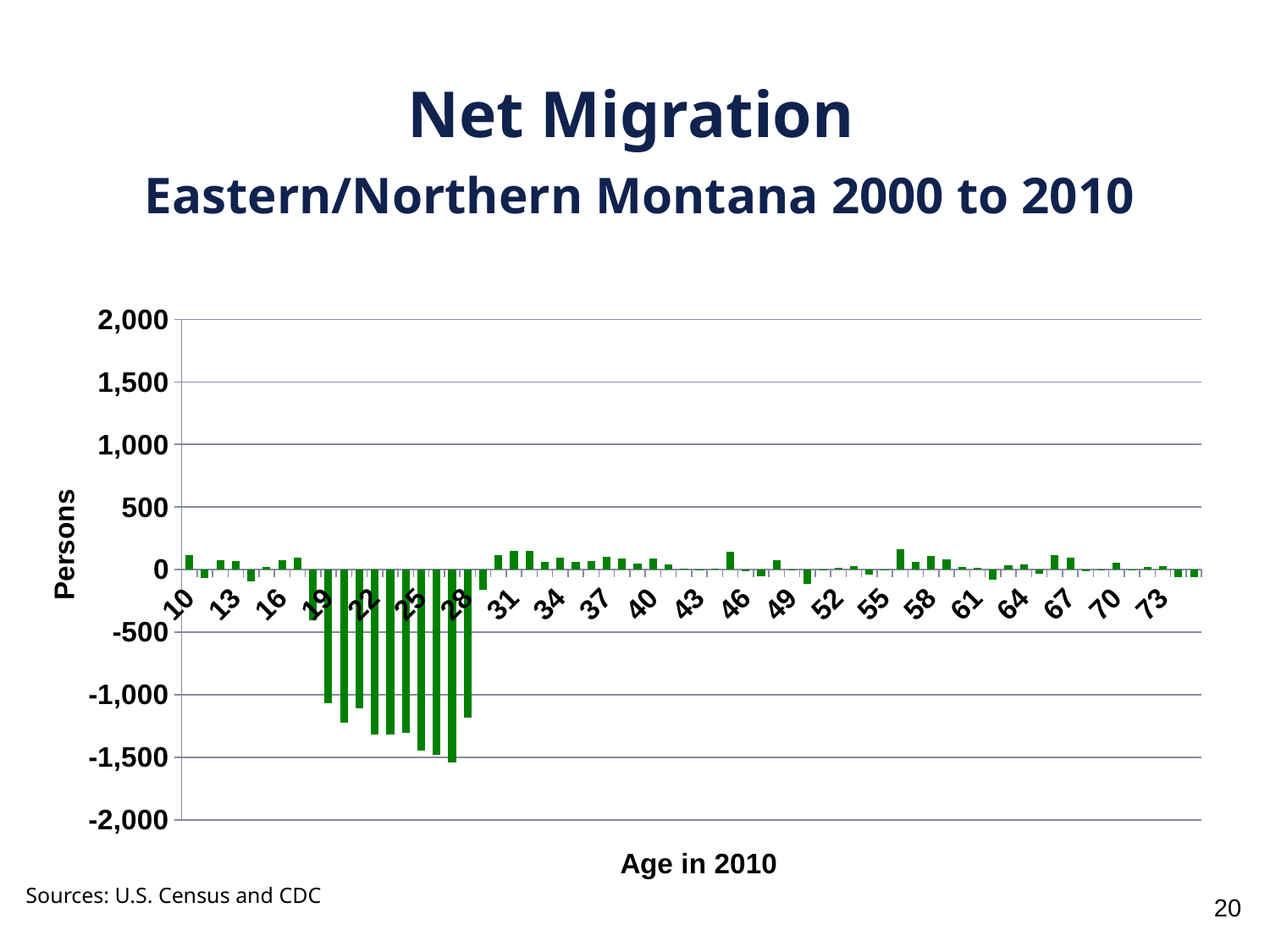
Is the value for age 22 greater or less than -1,000? less What kind of chart is shown on the slide? bar chart Is the value for age 10 greater or less than 500? less Is the value for age 10 greater or less than 0? greater Which has the larger value, age 10 or age 19? age 10 What is the title of the chart? Net Migration Eastern/Northern Montana 2000 to 2010 What is the highest value shown on the vertical axis? 2,000 What is the label of the horizontal axis? Age in 2010 Which has the larger value, age 31 or age 22? age 31